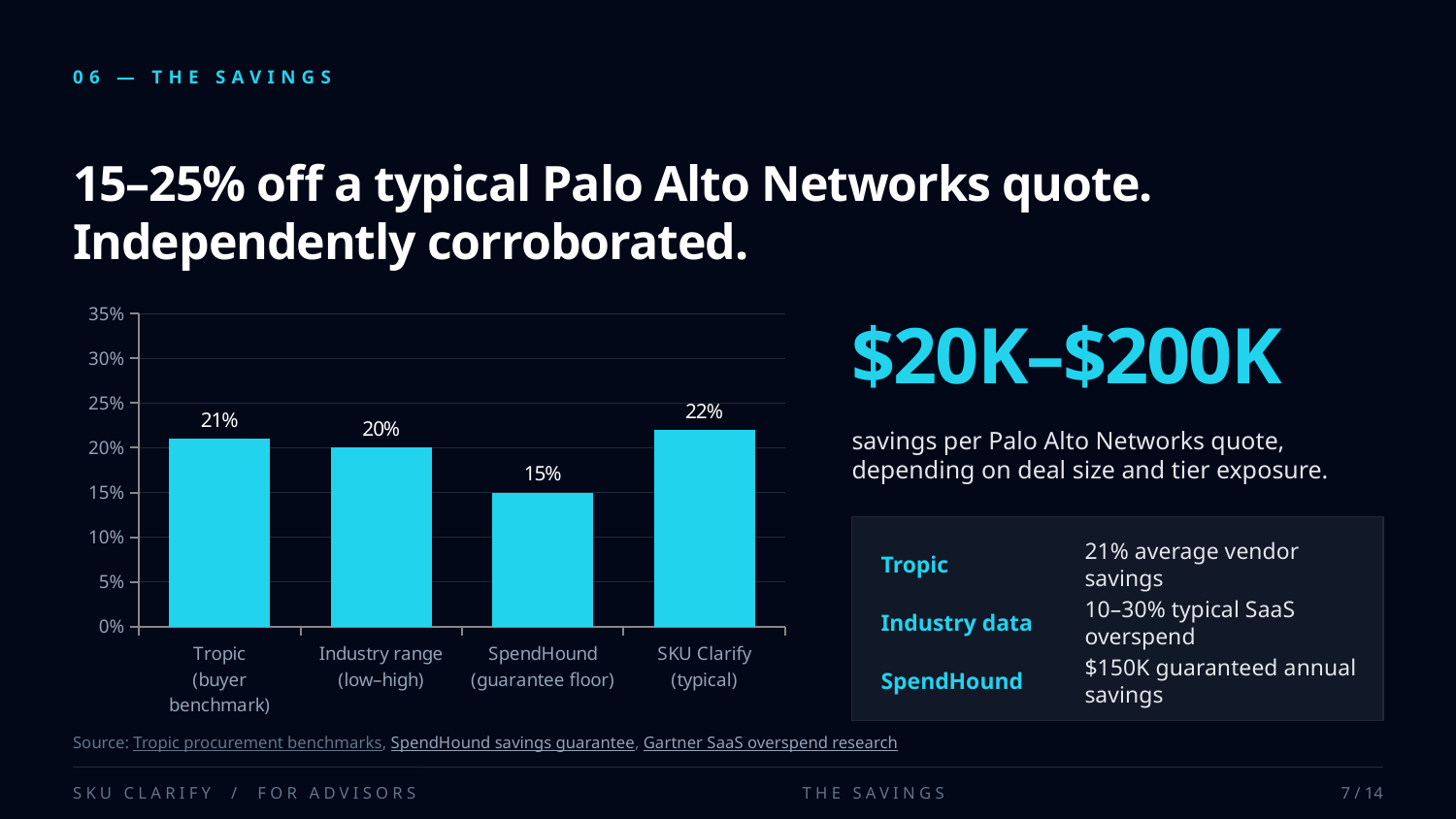
How many categories are shown on the chart? 4 What is the difference between the values for SKU Clarify (typical) and SpendHound (guarantee floor)? 7% What is the maximum value shown on the chart's vertical axis? 35% Is the value for Industry range (low–high) greater or less than 25%? less Which category has the highest value? SKU Clarify (typical) What is the value for Tropic (buyer benchmark)? 21% Which is larger, the value for Tropic (buyer benchmark) or the value for SpendHound (guarantee floor)? Tropic (buyer benchmark) What is the value for SKU Clarify (typical)? 22% Which category has the lowest value? SpendHound (guarantee floor) What is the value for Industry range (low–high)? 20% What is the value for SpendHound (guarantee floor)? 15% What kind of chart is shown on the slide? bar chart